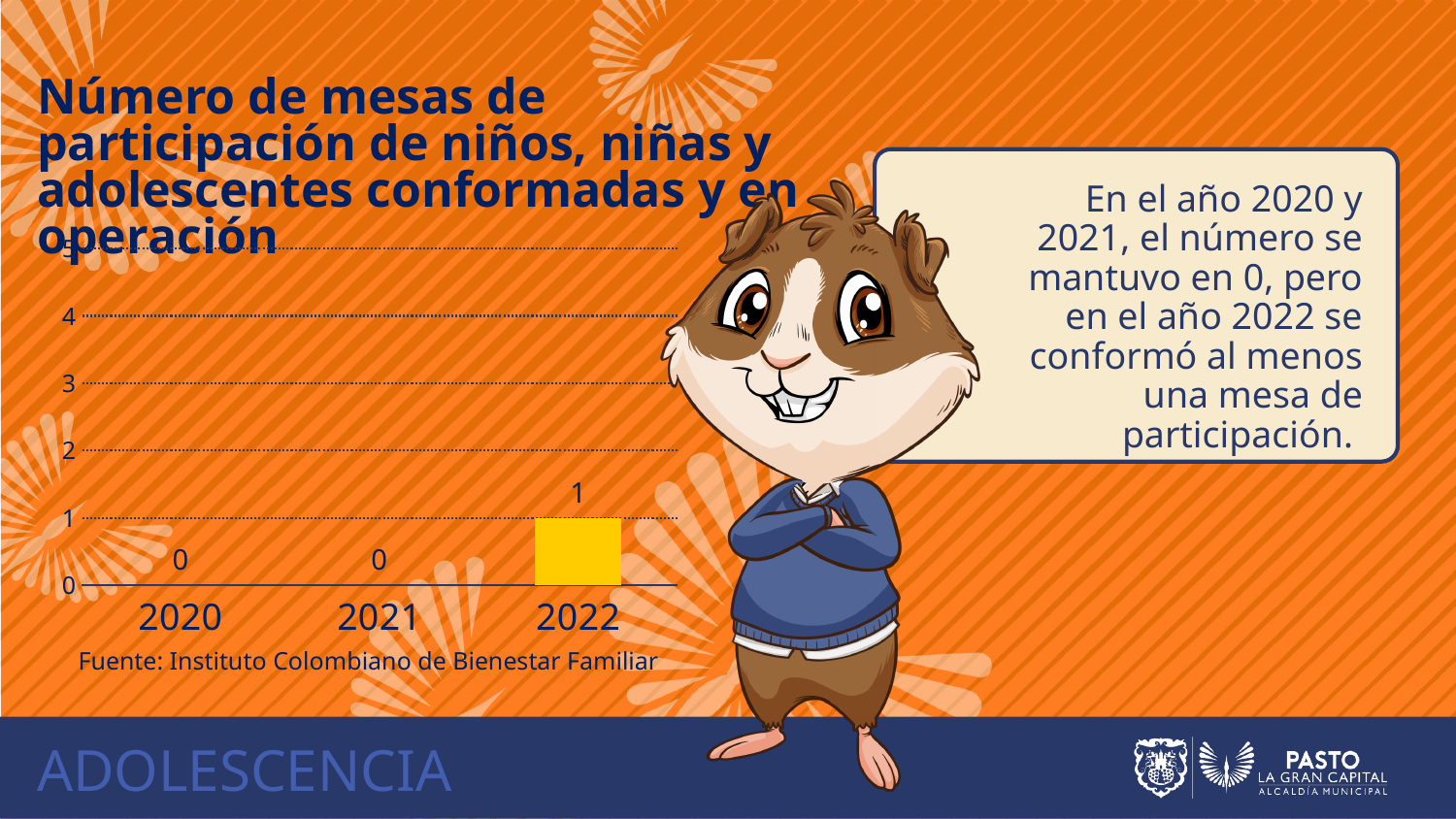
What is the difference between the values for 2022 and 2021? 1 How many years are shown on the x axis? 3 What is the value for 2022? 1 What is the highest value shown on the y axis? 5 Which is larger, the value for 2022 or the value for 2020? 2022 What is the value for 2020? 0 What kind of chart is shown? bar chart What is the value for 2021? 0 Which year has the highest value? 2022 Is the value for 2022 greater or less than 2? less Do the values rise or fall from 2021 to 2022? rise What is the source cited below the chart? Instituto Colombiano de Bienestar Familiar